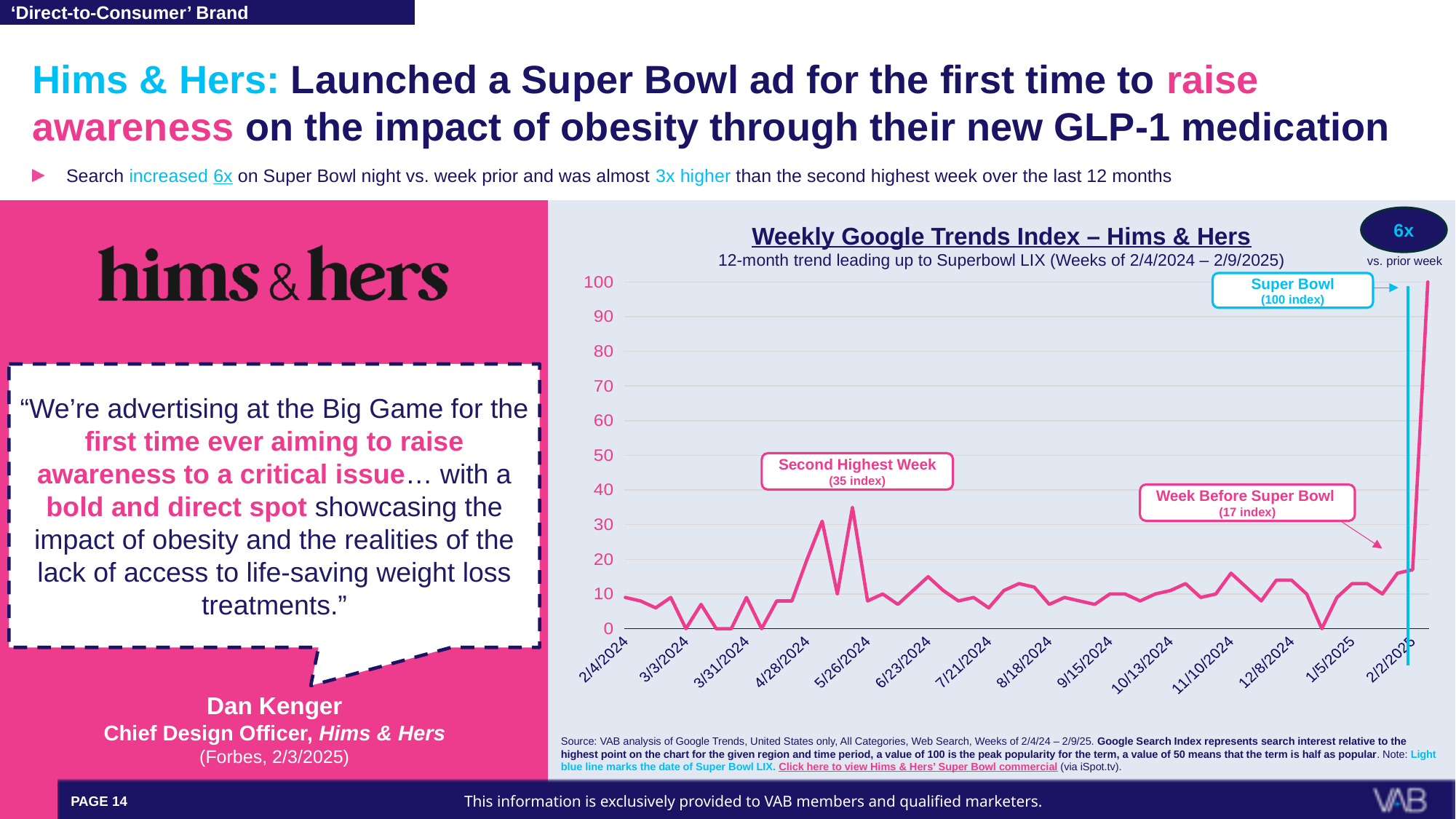
What kind of chart is shown on the slide? line chart What is the difference between the Super Bowl week index and the Week Before Super Bowl index? 83 What is the title of the chart on the slide? Weekly Google Trends Index – Hims & Hers Which week has the highest value on the chart? Super Bowl week What is the difference between the Super Bowl week index and the Second Highest Week index? 65 What index value does the chart annotation give for the Super Bowl week? 100 index What is the highest value shown on the chart's y axis? 100 Is the value for the week of 2/4/2024 greater or less than 20? less What index value does the chart annotation give for the Week Before Super Bowl? 17 index Which is larger, the index for the Second Highest Week or the index for the Week Before Super Bowl? Second Highest Week What is the first date label on the x axis of the chart? 2/4/2024 What index value does the chart annotation give for the Second Highest Week? 35 index